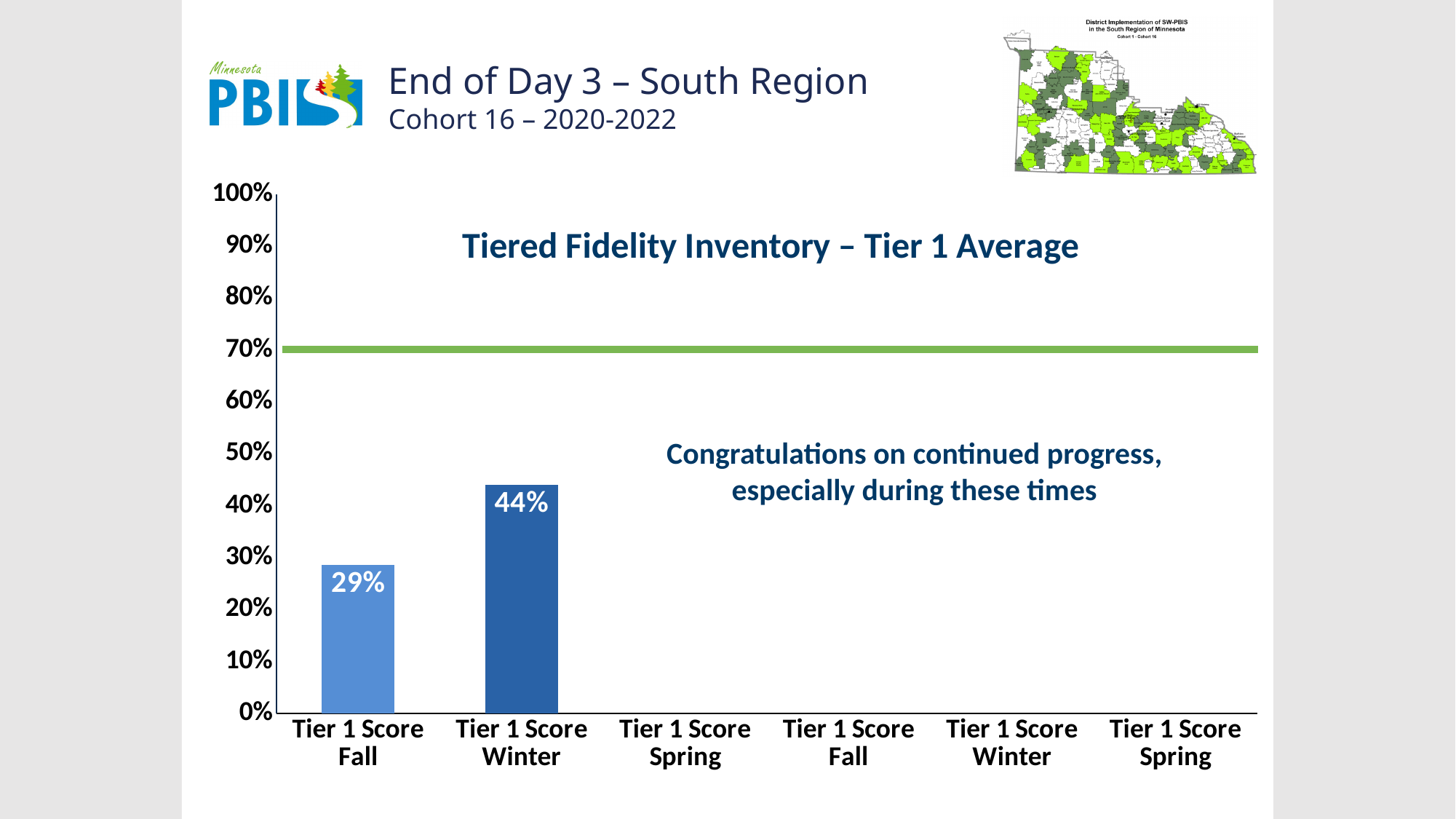
At what percentage is the green horizontal line drawn across the chart? 70% How many bars are actually plotted on the chart? 2 Which is larger, the Tier 1 Score Fall bar or the Tier 1 Score Winter bar? Tier 1 Score Winter What is the difference between the Tier 1 Score Winter bar and the Tier 1 Score Fall bar? 15% Is the value for the Tier 1 Score Winter bar greater or less than 50%? less What is the value of the first Tier 1 Score Fall bar? 29% What is the value of the first Tier 1 Score Winter bar? 44% How many category labels are shown along the x axis? 6 Do the plotted values rise or fall from Fall to Winter? rise Which of the two plotted bars is the lowest? Tier 1 Score Fall What kind of chart is shown on the slide? bar chart Which of the two plotted bars is the highest? Tier 1 Score Winter